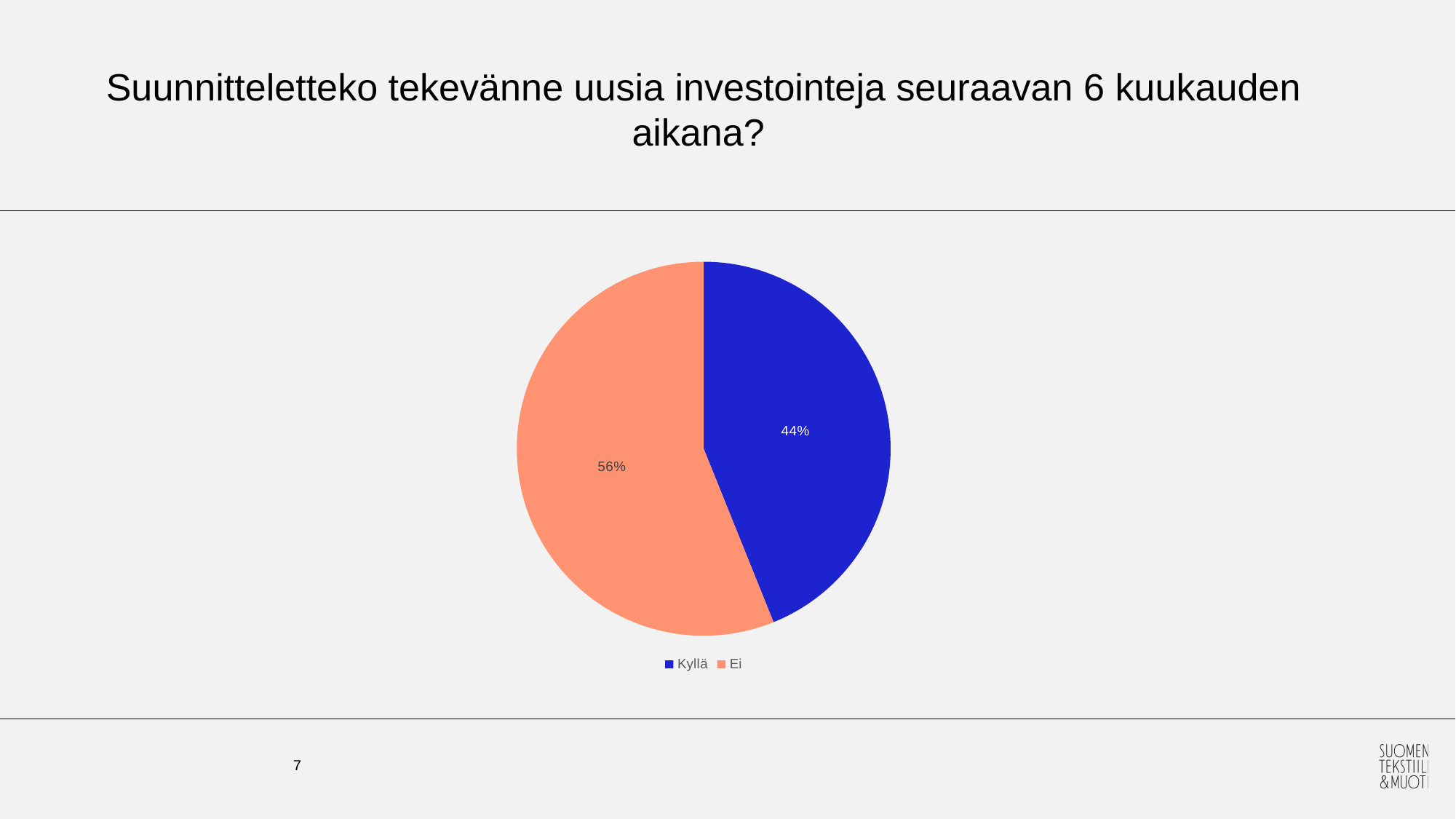
What is the difference in percentage points between the "Ei" and "Kyllä" slices? 12 How many entries does the legend list? 2 Which slice is the smallest in the pie chart? Kyllä Which is larger, the "Kyllä" slice or the "Ei" slice? Ei Is the share for "Kyllä" greater or less than 50%? less What is the title of the slide above the chart? Suunnitteletteko tekevänne uusia investointeja seuraavan 6 kuukauden aikana? How many slices does the pie chart have? 2 What kind of chart is shown on the slide? Pie chart What colour is the "Kyllä" slice? Blue Which slice is the largest in the pie chart? Ei What share of the pie does the "Kyllä" slice represent? 44% What share of the pie does the "Ei" slice represent? 56%